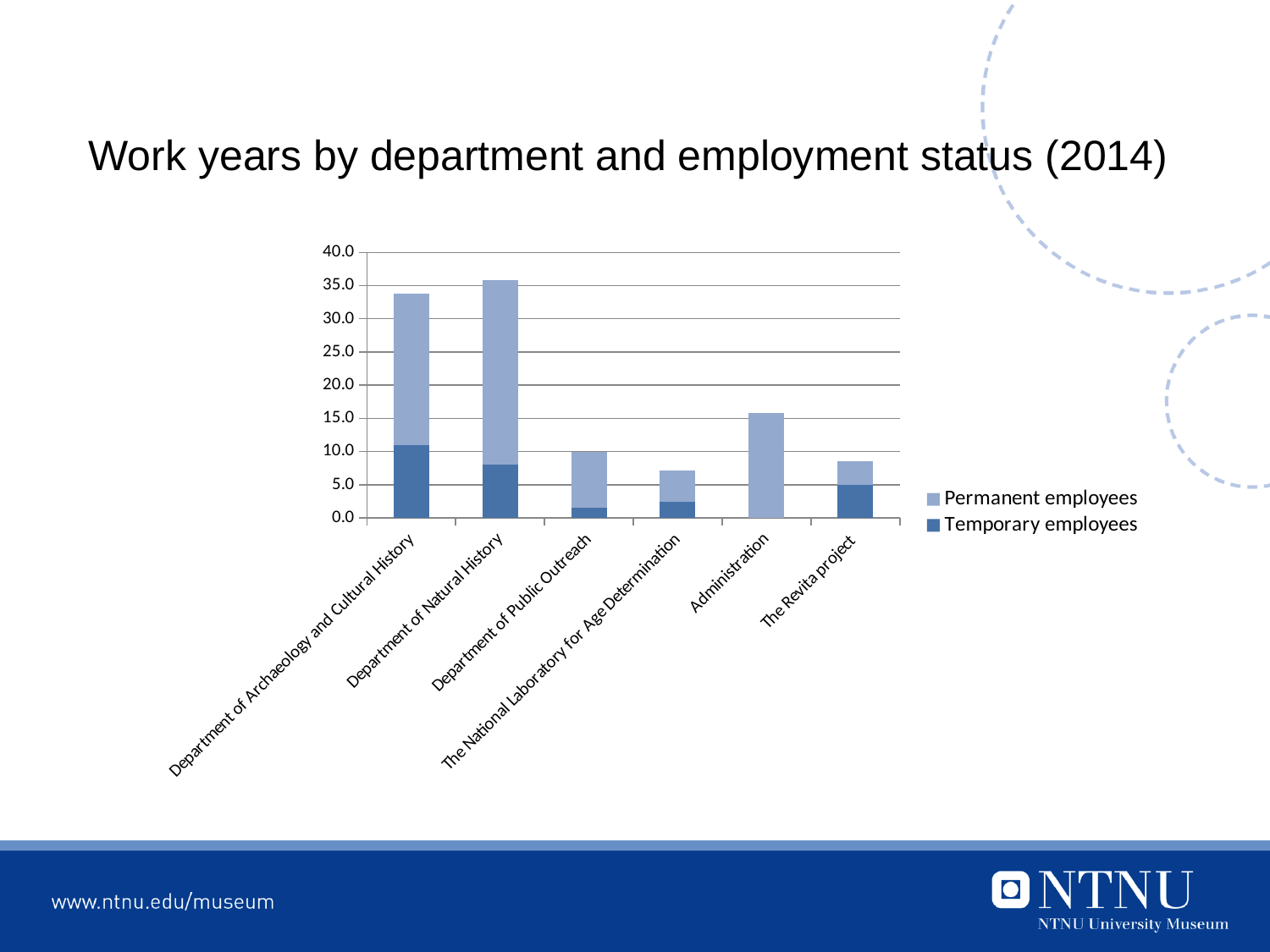
Which department has the tallest total bar? Department of Natural History Is the total bar for the Department of Natural History greater or less than 30.0? greater Which has a taller total bar: the Department of Archaeology and Cultural History or Administration? Department of Archaeology and Cultural History Is the total bar for Administration greater or less than 10.0? greater What kind of chart is shown on the slide? Stacked bar chart Is the total bar for The National Laboratory for Age Determination greater or less than 10.0? less What is the title of the chart? Work years by department and employment status (2014) How many departments (categories) are shown on the x axis? 6 How many series does the legend list? 2 Which department has the largest Temporary employees segment? Department of Archaeology and Cultural History Which has a larger Temporary employees segment: the Department of Public Outreach or The Revita project? The Revita project